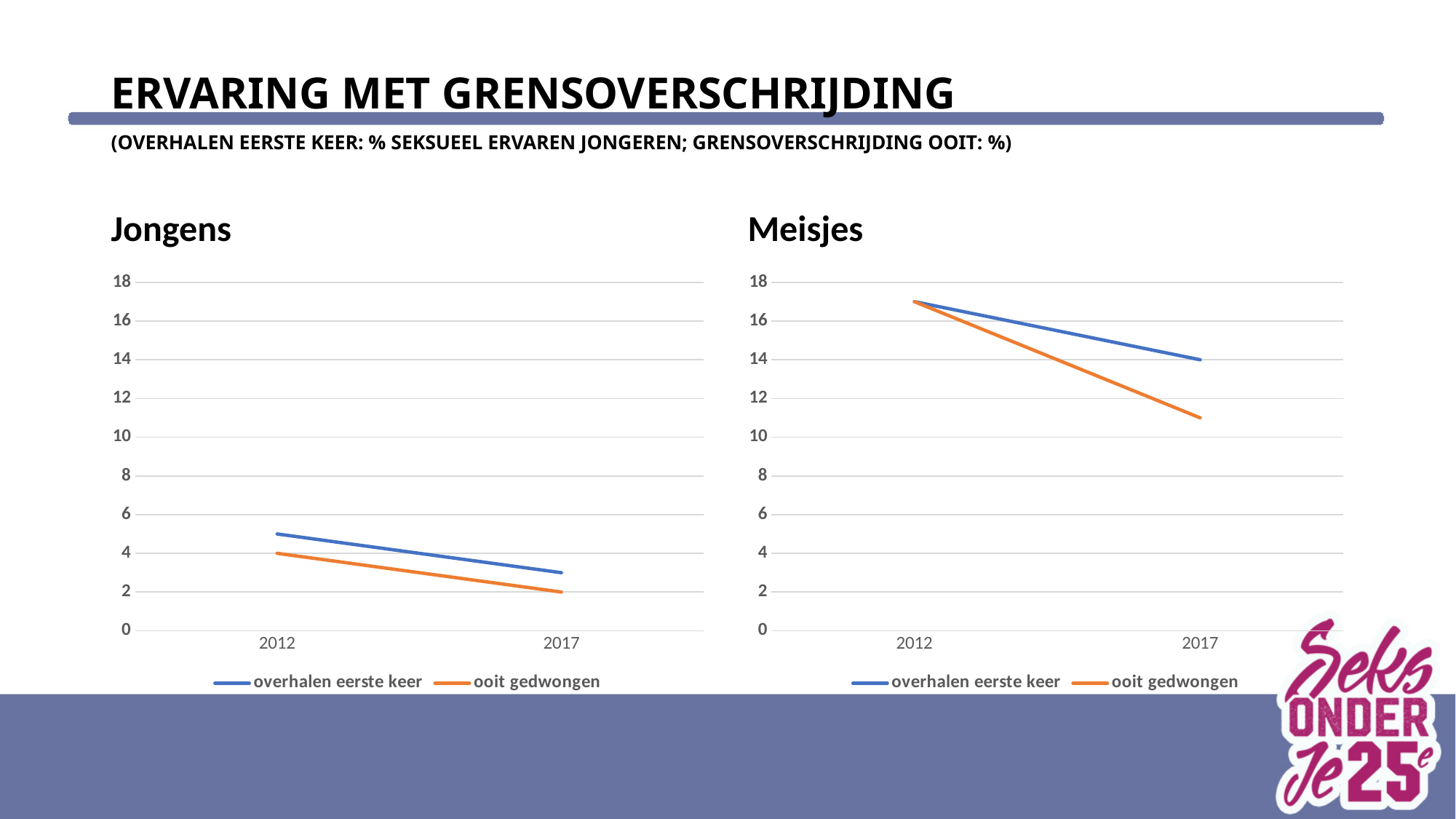
In the Jongens chart, what is the value for ooit gedwongen in 2017? 2 In the Meisjes chart, what is the value for overhalen eerste keer in 2017? 14 In the Jongens chart, what is the value for ooit gedwongen in 2012? 4 How many points on the x axis does the Jongens chart show? 2 In the Meisjes chart, is the value for ooit gedwongen in 2017 greater or less than 12? less In the Jongens chart, is the value for overhalen eerste keer in 2012 greater or less than 6? less How many series does the legend of the Meisjes chart list? 2 What kind of chart is the Jongens chart? line chart In the Meisjes chart, is the value for overhalen eerste keer in 2012 greater or less than 16? greater In the Meisjes chart, does the ooit gedwongen line rise or fall from 2012 to 2017? fall In the Meisjes chart, which series has the higher value in 2017, overhalen eerste keer or ooit gedwongen? overhalen eerste keer Which colour is used for the ooit gedwongen series in the Jongens chart? orange